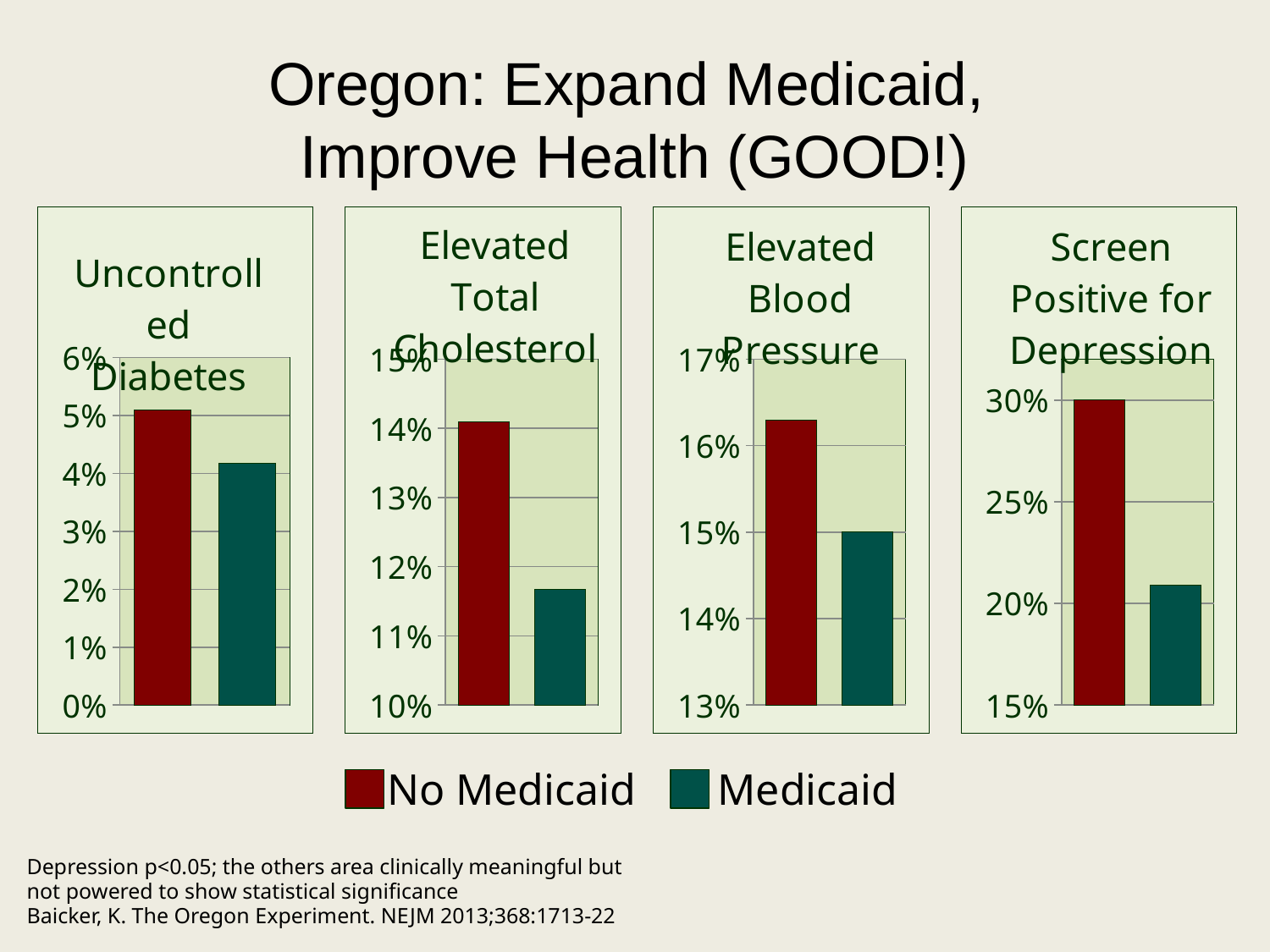
In the 'Elevated Blood Pressure' chart, is the value for No Medicaid greater or less than 16%? greater In the 'Uncontrolled Diabetes' chart, which bar is taller, No Medicaid or Medicaid? No Medicaid What are the two series named in the legend? No Medicaid, Medicaid How many series does the legend list? 2 In the 'Uncontrolled Diabetes' chart, is the value for Medicaid greater or less than 5%? less What kind of chart is used in the 'Uncontrolled Diabetes' panel? bar chart In the 'Elevated Total Cholesterol' chart, is the value for Medicaid greater or less than 12%? less In the 'Elevated Blood Pressure' chart, which group has the lower value? Medicaid In the 'Elevated Total Cholesterol' chart, which group has the higher value? No Medicaid How many bars are plotted in the 'Screen Positive for Depression' chart? 2